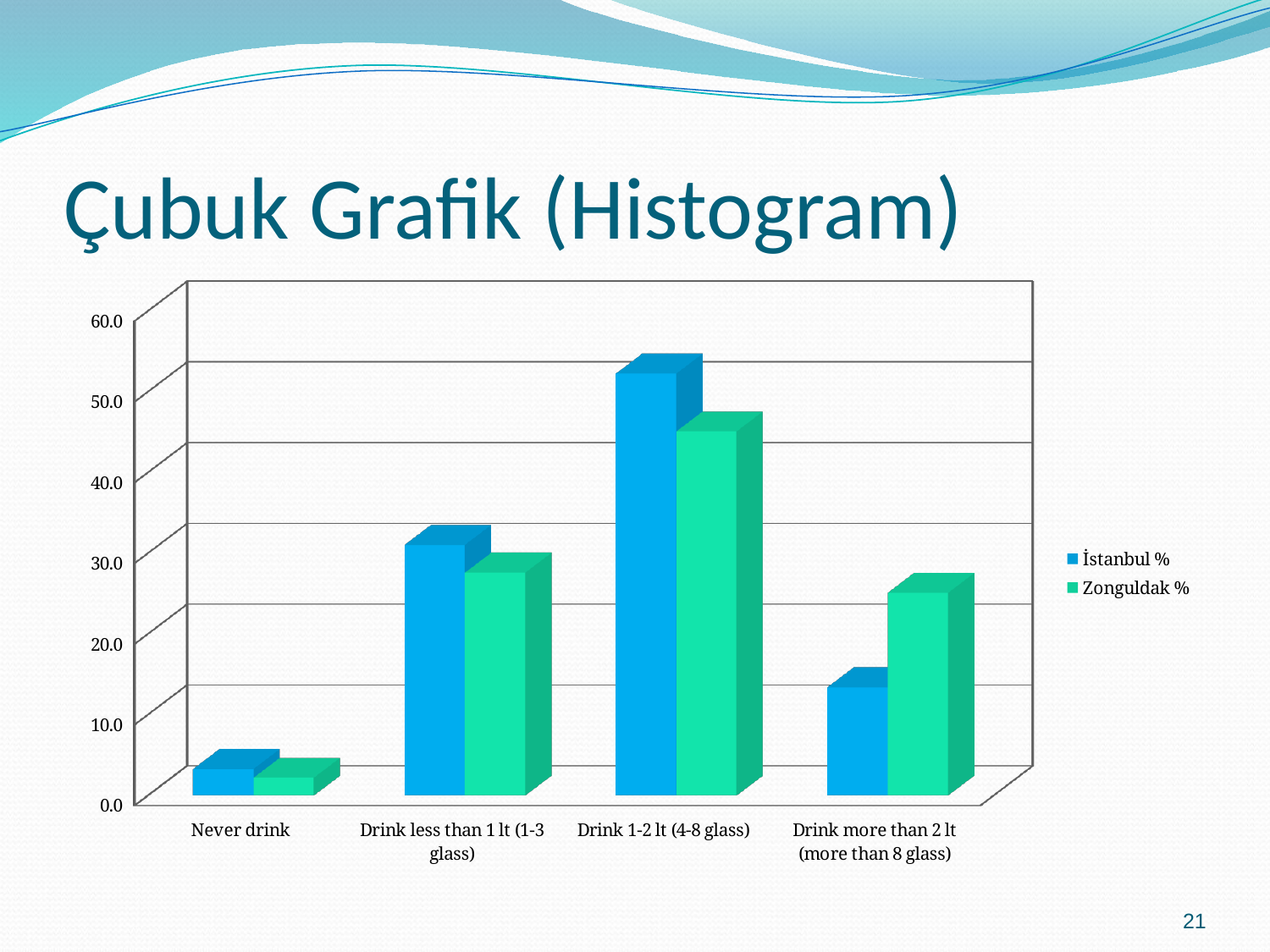
How many series does the legend list? 2 What are the two entries listed in the chart legend? İstanbul % and Zonguldak % Is the İstanbul % value for 'Drink 1-2 lt (4-8 glass)' greater or less than 50.0? greater For the category 'Drink 1-2 lt (4-8 glass)', which series has the larger value, İstanbul % or Zonguldak %? İstanbul % Which category has the highest value for İstanbul %? Drink 1-2 lt (4-8 glass) Is the İstanbul % value for 'Drink more than 2 lt (more than 8 glass)' greater or less than 20.0? less Is the Zonguldak % value for 'Drink 1-2 lt (4-8 glass)' greater or less than 50.0? less Which category has the lowest value for Zonguldak %? Never drink What kind of chart is shown on the slide? bar chart How many categories are shown on the x axis? 4 For the category 'Drink more than 2 lt (more than 8 glass)', which series has the larger value, İstanbul % or Zonguldak %? Zonguldak %